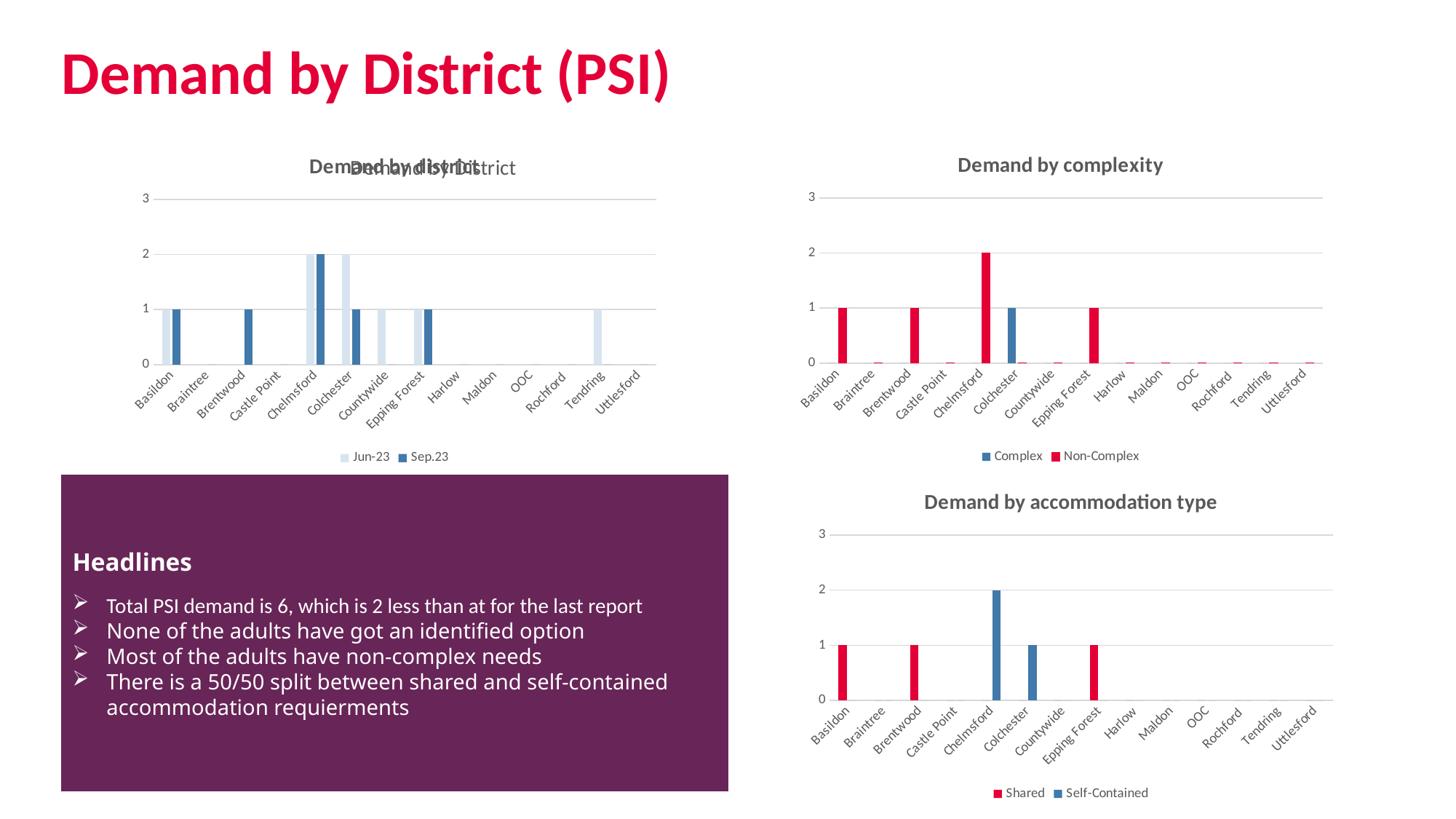
In the 'Demand by accommodation type' chart, what is the Shared value for Basildon? 1 In the 'Demand by complexity' chart, which district has the highest Non-Complex value? Chelmsford In the 'Demand by complexity' chart, what is the Non-Complex value for Chelmsford? 2 In the 'Demand by complexity' chart, which district has a Complex value of 1? Colchester In the 'Demand by accommodation type' chart, which district has the highest Self-Contained value? Chelmsford In the 'Demand by accommodation type' chart, what is the difference between the Self-Contained values for Chelmsford and Colchester? 1 What kind of chart is the 'Demand by complexity' chart? Bar chart In the 'Demand by district' chart (top left), which is larger for Colchester: the Jun-23 value or the Sep.23 value? Jun-23 In the 'Demand by district' chart (top left), what is the Jun-23 value for Chelmsford? 2 In the 'Demand by district' chart (top left), what is the Sep.23 value for Colchester? 1 How many series does the legend of the 'Demand by accommodation type' chart list? 2 In the 'Demand by accommodation type' chart, what is the Self-Contained value for Chelmsford? 2